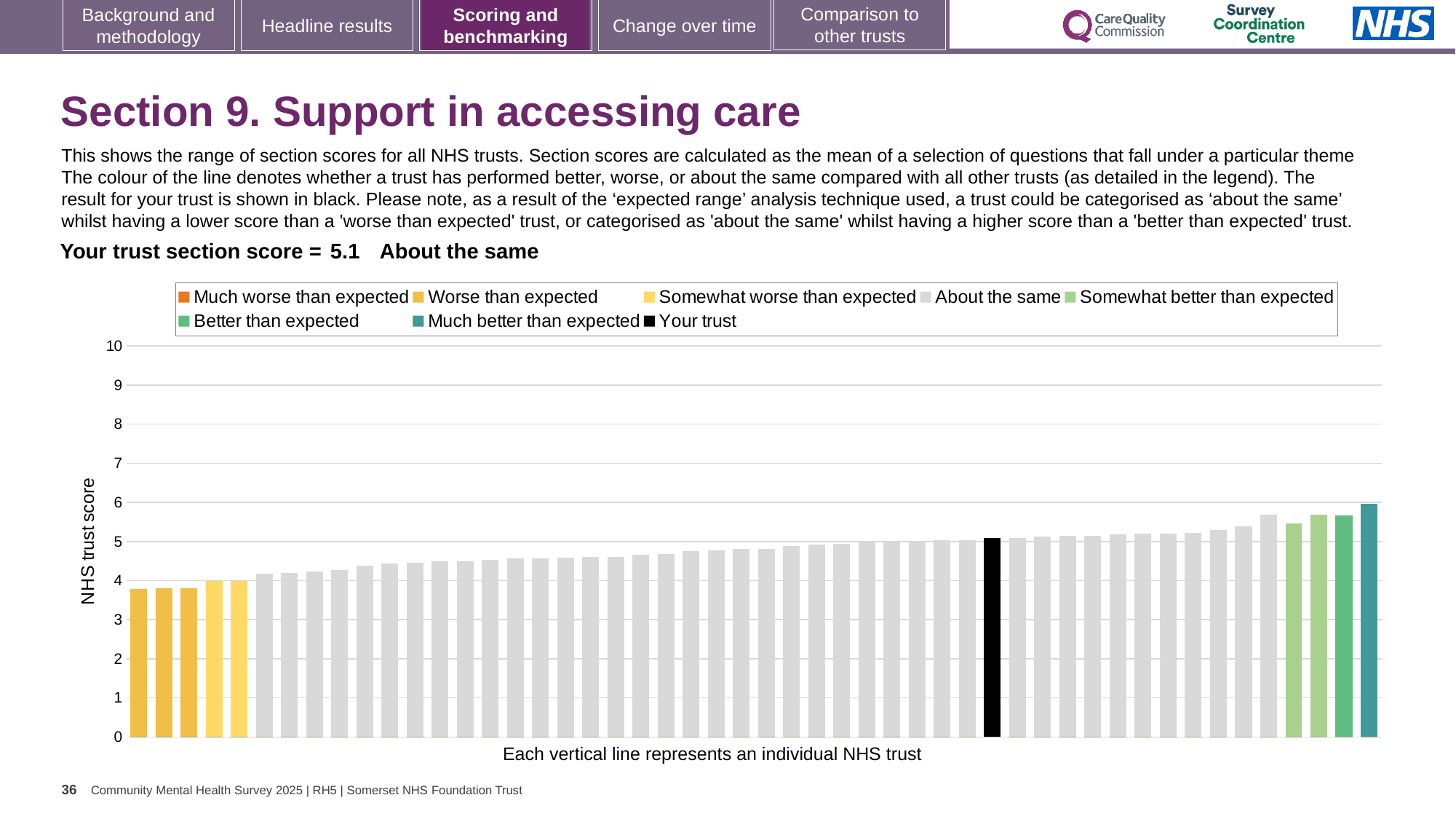
How many entries does the chart legend list? 8 Is the value of the black 'Your trust' bar greater or less than 5? greater Which legend category do the shortest bars belong to? Worse than expected Which performance category is your trust placed in for this section? About the same Is the value of the rightmost bar greater or less than 5? greater What kind of chart is shown on the slide? bar chart Is the value of the leftmost bar greater or less than 4? less Which legend category does the tallest bar belong to? Much better than expected What is the label on the vertical axis of the chart? NHS trust score How many bars are coloured as 'Much better than expected'? 1 Do the bar values rise or fall from left to right across the chart? rise What is the section score for your trust shown on the slide? 5.1